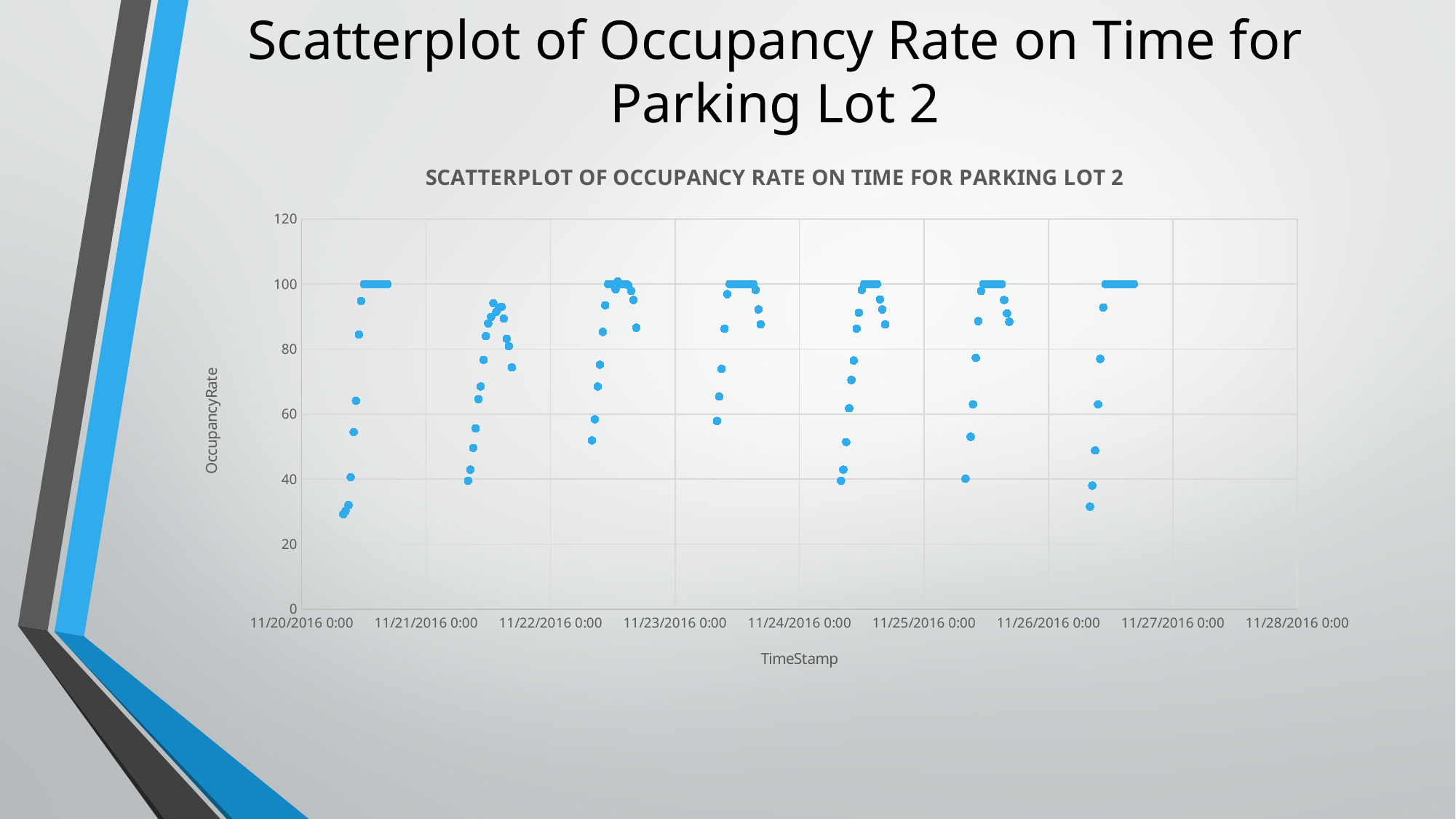
What is the label of the vertical axis? OccupancyRate What is the title of the chart? Scatterplot of Occupancy Rate on Time for Parking Lot 2 How many date labels are shown along the horizontal axis? 9 Is the lowest occupancy rate plotted on 11/26/2016 greater or less than 40? less What kind of chart is shown on the slide? Scatter plot What is the first date label on the horizontal axis? 11/20/2016 0:00 Is the lowest occupancy rate plotted on 11/20/2016 greater or less than 40? less Is the lowest occupancy rate plotted on 11/20/2016 greater or less than 20? greater How many separate daily clusters of points are plotted? 7 What is the highest value shown on the vertical axis? 120